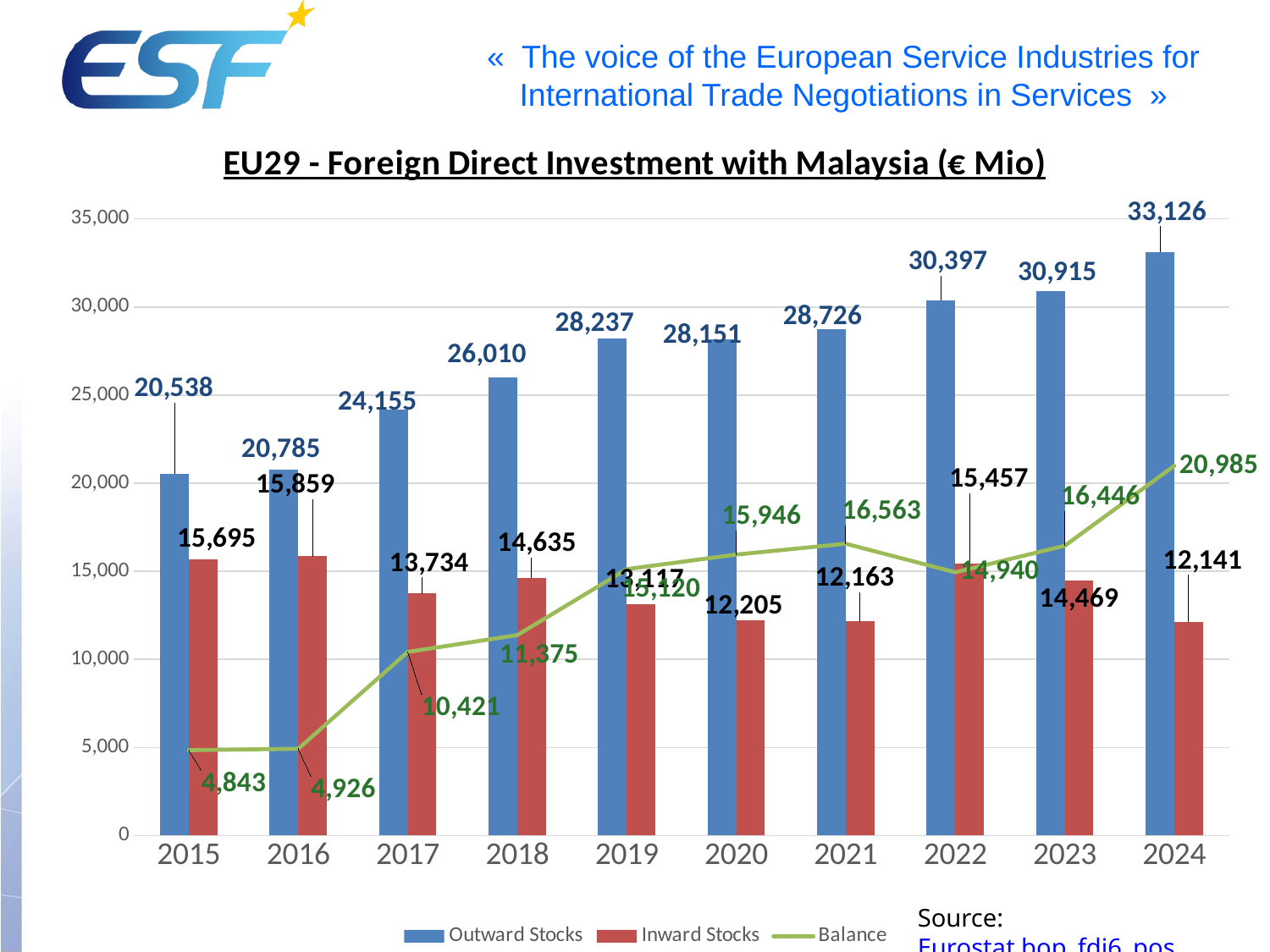
How many years are shown on the x axis? 10 What is the difference between Outward Stocks and Inward Stocks in 2015? 4,843 What is the Outward Stocks value for 2024? 33,126 Which year has the highest Outward Stocks value? 2024 What kind of chart is used for the Outward Stocks and Inward Stocks series? Bar chart How many series does the legend list? 3 Which is larger in 2022: Inward Stocks or Balance? Inward Stocks Does the Balance line generally rise or fall from 2015 to 2024? Rise Which year has the lowest Balance value? 2015 What is the Balance value for 2021? 16,563 What is the Inward Stocks value for 2018? 14,635 Is the Outward Stocks value for 2019 greater or less than 25,000? greater